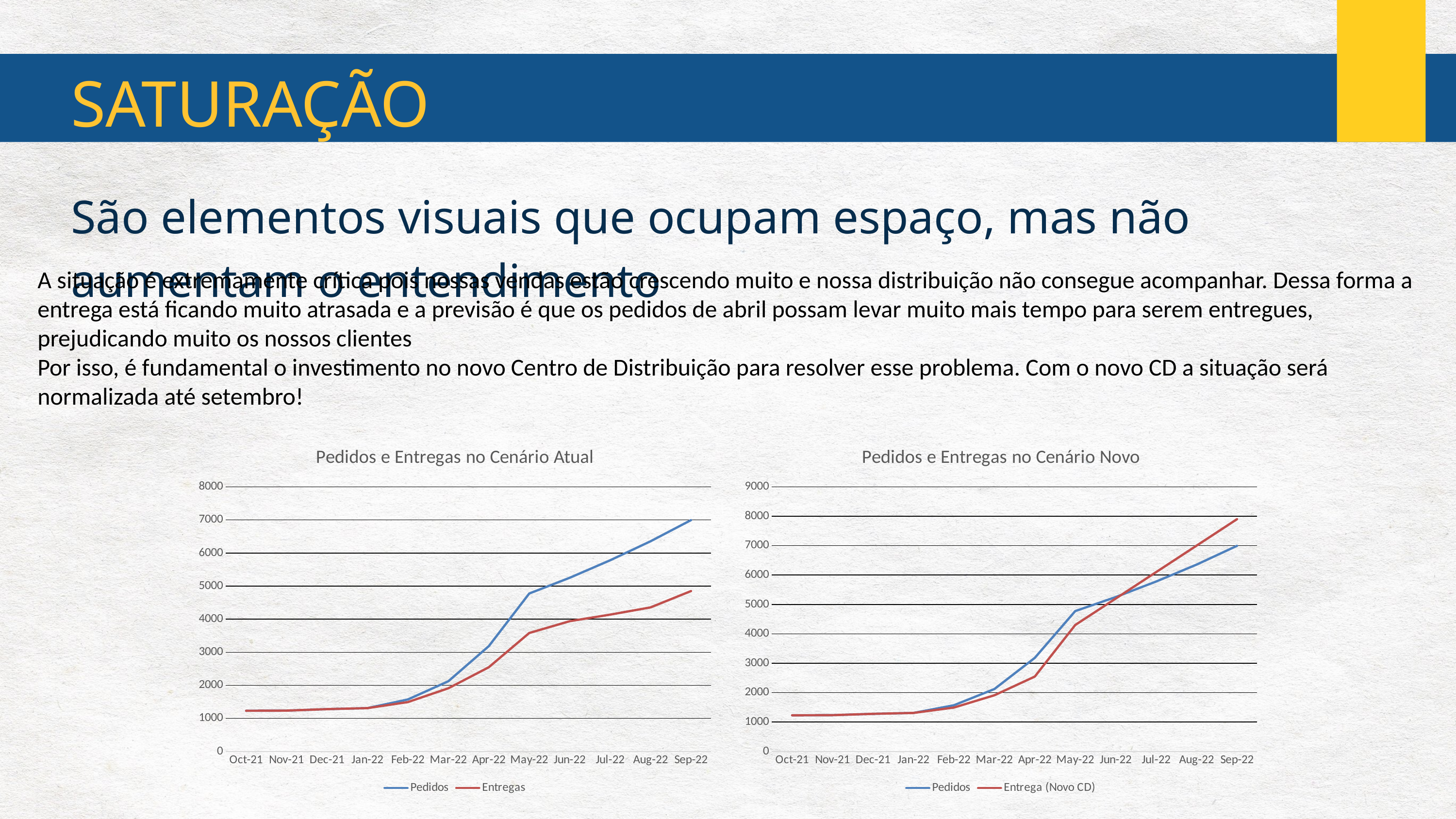
What is the title of the chart on the left of the slide? Pedidos e Entregas no Cenário Atual In "Pedidos e Entregas no Cenário Atual", is the value of Entregas for Sep-22 greater or less than 5000? less How many months are shown on the x axis of "Pedidos e Entregas no Cenário Atual"? 12 In "Pedidos e Entregas no Cenário Novo", which series is higher at Sep-22, Pedidos or Entrega (Novo CD)? Entrega (Novo CD) In "Pedidos e Entregas no Cenário Atual", which series is higher at Sep-22, Pedidos or Entregas? Pedidos What is the name of the red series in the legend of "Pedidos e Entregas no Cenário Novo"? Entrega (Novo CD) In "Pedidos e Entregas no Cenário Atual", is the value of Pedidos for May-22 greater or less than 4000? greater In "Pedidos e Entregas no Cenário Novo", is the value of Entrega (Novo CD) for Apr-22 greater or less than 3000? less How many series does the legend of "Pedidos e Entregas no Cenário Novo" list? 2 In "Pedidos e Entregas no Cenário Atual", do the Pedidos values rise or fall from Oct-21 to Sep-22? rise What type of chart is "Pedidos e Entregas no Cenário Atual"? line chart